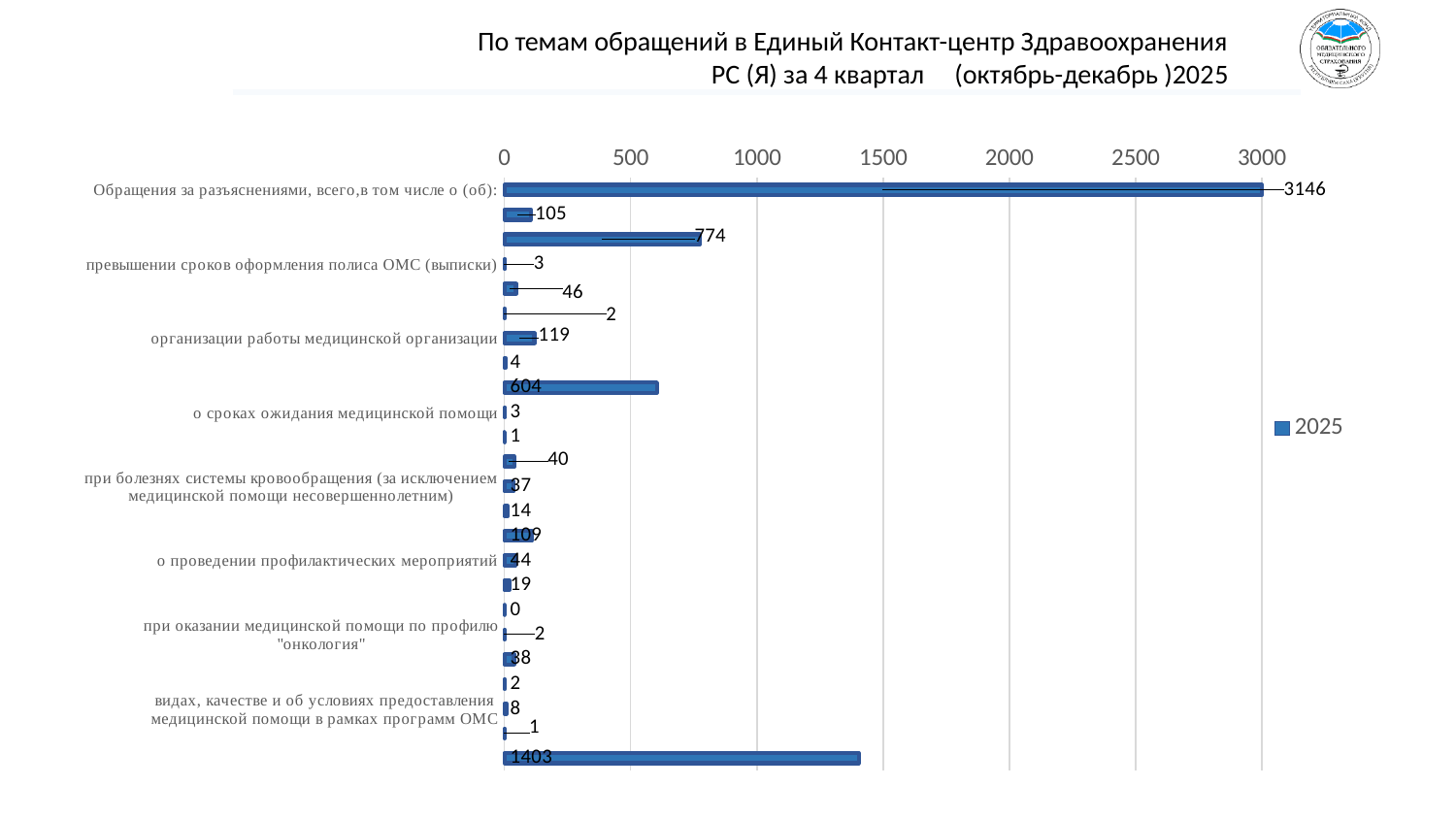
What is the value for "видах, качестве и об условиях предоставления медицинской помощи в рамках программ ОМС"? 8 What is the value for "Обращения за разъяснениями, всего,в том числе о (об):"? 3146 What is the value for "о проведении профилактических мероприятий"? 44 What is the difference between the value for "Обращения за разъяснениями, всего,в том числе о (об):" and the value for "организации работы медицинской организации"? 3027 How many series does the legend list? 1 Is the value for "Обращения за разъяснениями, всего,в том числе о (об):" greater or less than 3000? greater What is the legend entry of the chart? 2025 What is the value for "организации работы медицинской организации"? 119 Which category has the highest value? Обращения за разъяснениями, всего,в том числе о (об): Which is larger: the value for "организации работы медицинской организации" or the value for "о проведении профилактических мероприятий"? организации работы медицинской организации What is the value for "при болезнях системы кровообращения (за исключением медицинской помощи несовершеннолетним)"? 37 What kind of chart is shown on the slide? bar chart